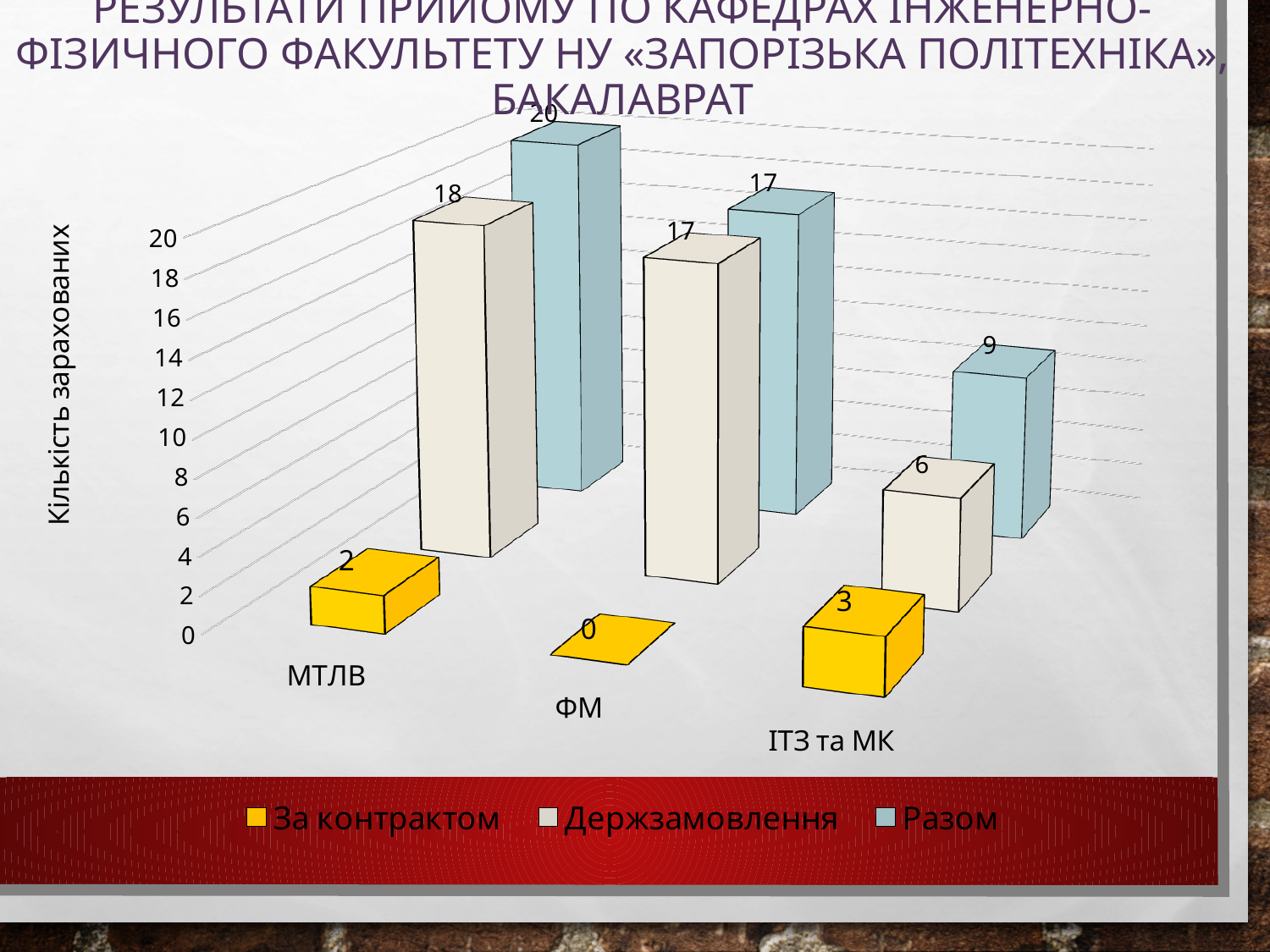
Which category has the lowest Держзамовлення value? ІТЗ та МК What is the difference between the Держзамовлення values for МТЛВ and ІТЗ та МК? 12 Which is larger: За контрактом for МТЛВ or За контрактом for ІТЗ та МК? ІТЗ та МК How many series does the legend list? 3 What type of chart is shown on the slide? bar chart What is the value of За контрактом for ФМ? 0 What is the label of the vertical axis? Кількість зарахованих What is the value of Разом for МТЛВ? 20 What is the value of За контрактом for ІТЗ та МК? 3 Which category has the highest Разом value? МТЛВ What is the value of Держзамовлення for ФМ? 17 How many categories are shown on the x axis? 3